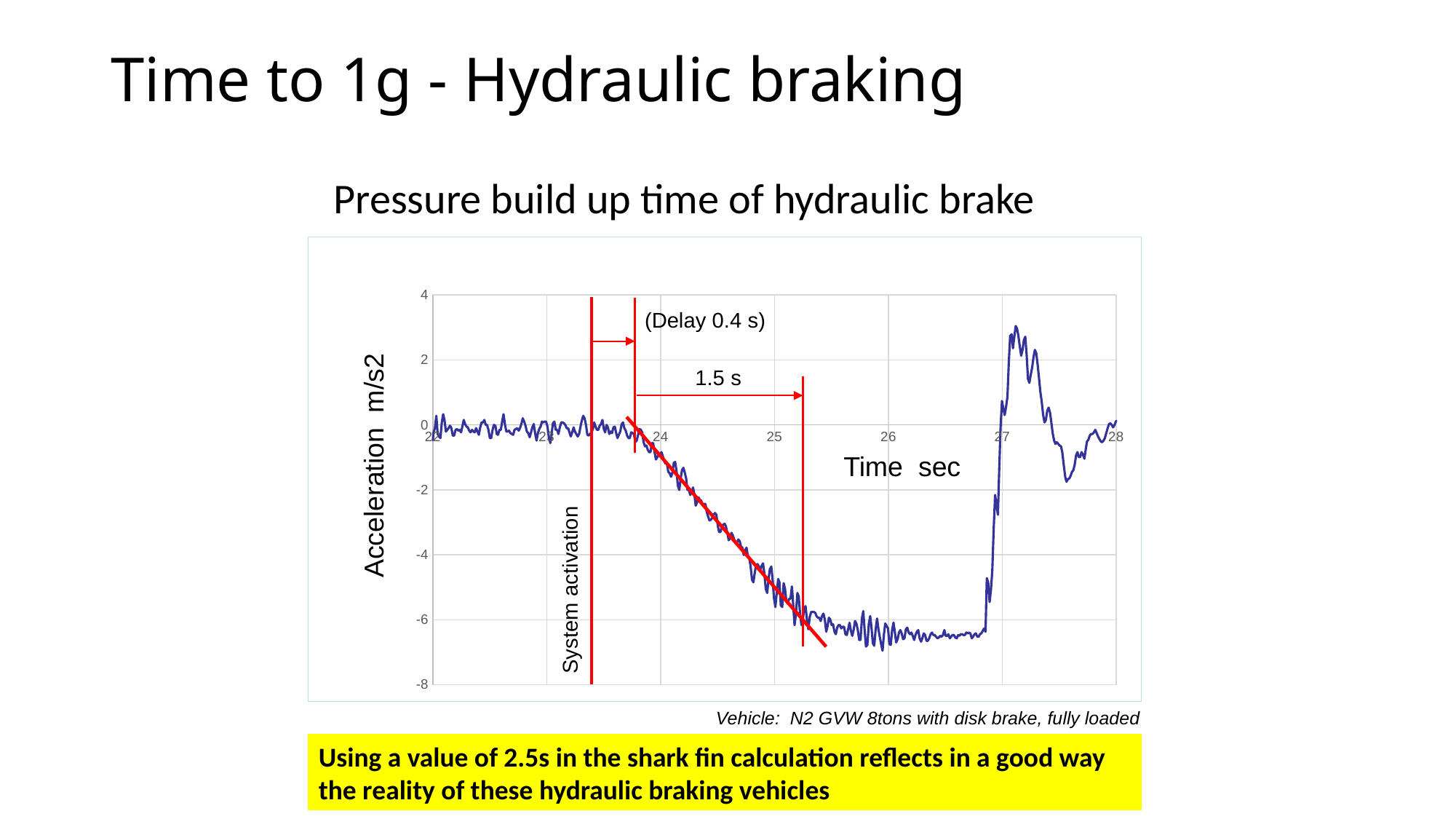
Between time 24 sec and 25 sec, does the acceleration rise or fall? fall What is the title of the chart? Pressure build up time of hydraulic brake Is the acceleration value at time 23 sec greater or less than -2? greater Is the acceleration value at time 26 sec greater or less than -4? less What kind of chart is shown on the slide? line chart What is the label of the vertical axis of the chart? Acceleration m/s2 What is the highest tick value shown on the horizontal time axis? 28 What delay is annotated on the chart after system activation? 0.4 s Is the peak acceleration value just after 27 sec greater or less than 2? greater What time interval is annotated by the longer red arrow on the chart? 1.5 s Which is larger, the acceleration value at time 23 sec or at time 26 sec? 23 sec What is the lowest value shown on the vertical axis of the chart? -8